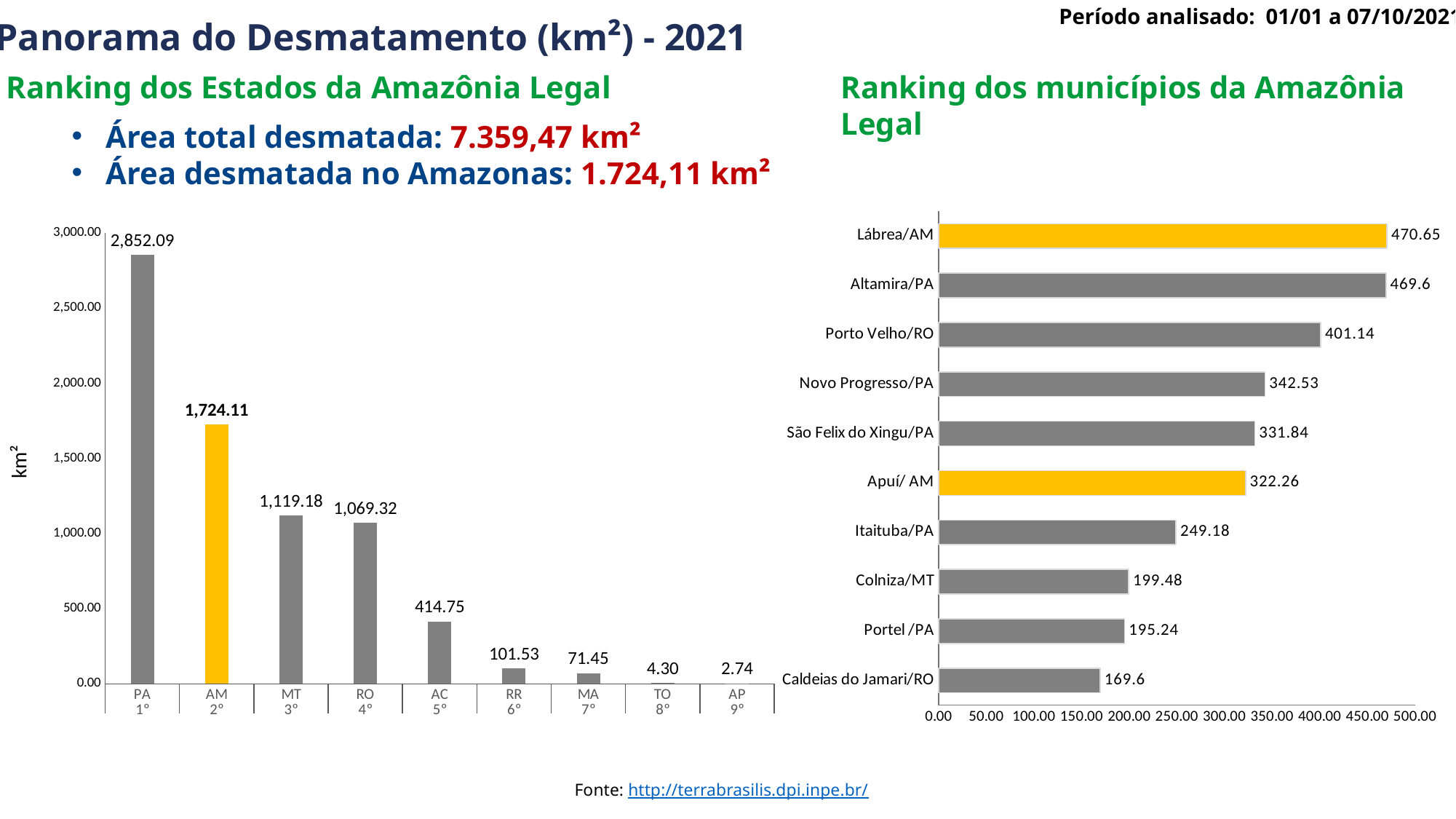
In the 'Ranking dos Estados da Amazônia Legal' chart, what is the value for MT? 1,119.18 In the 'Ranking dos Estados da Amazônia Legal' chart, what is the value for PA? 2,852.09 In the 'Ranking dos municípios da Amazônia Legal' chart, which municipality has the highest value? Lábrea/AM In the 'Ranking dos municípios da Amazônia Legal' chart, what is the value for Porto Velho/RO? 401.14 In the 'Ranking dos Estados da Amazônia Legal' chart, do the values rise or fall from left to right along the x axis? fall In the 'Ranking dos municípios da Amazônia Legal' chart, which is larger, the value for Apuí/ AM or the value for Itaituba/PA? Apuí/ AM In the 'Ranking dos municípios da Amazônia Legal' chart, how many municipalities are shown? 10 What kind of chart is the 'Ranking dos municípios da Amazônia Legal' chart? bar chart In the 'Ranking dos Estados da Amazônia Legal' chart, which state has the lowest value? AP In the 'Ranking dos Estados da Amazônia Legal' chart, is the value for AC greater or less than 500? less In the 'Ranking dos Estados da Amazônia Legal' chart, what is the difference between the values for PA and AM? 1,127.98 In the 'Ranking dos Estados da Amazônia Legal' chart, how many states are shown? 9